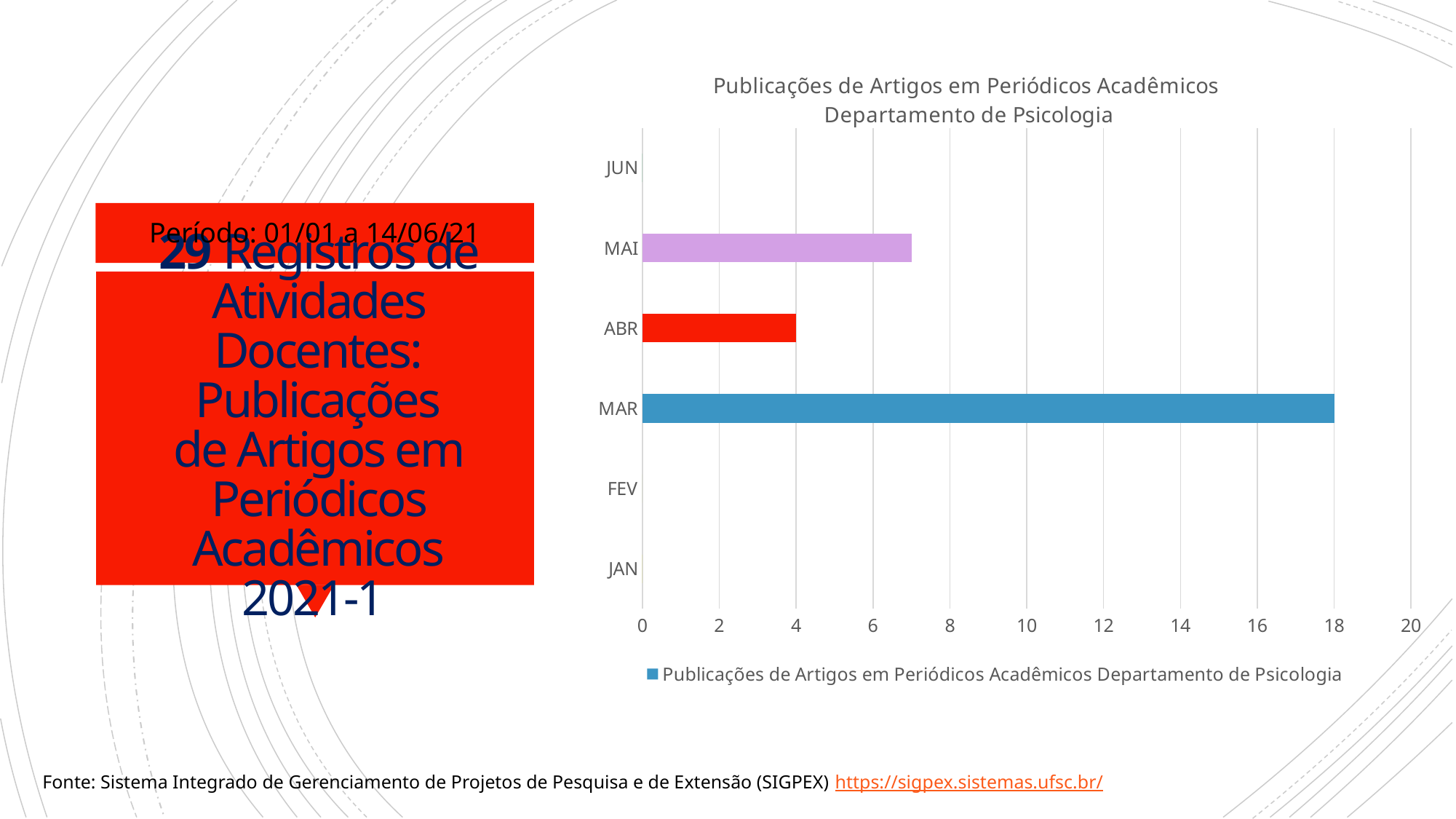
What is the title of the chart? Publicações de Artigos em Periódicos Acadêmicos Departamento de Psicologia What is the value for MAR in the chart? 18 How many months are listed on the vertical axis of the chart? 6 Which month has the highest number of publications in the chart? MAR What is the difference between the values for MAR and ABR? 14 What is the value for ABR in the chart? 4 What kind of chart is shown on the slide? bar chart Is the value for MAI greater or less than 8? less Is the value for MAI greater or less than 6? greater How many series does the chart legend list? 1 Which has a larger value, MAI or ABR? MAI What colour is the bar for MAR? blue